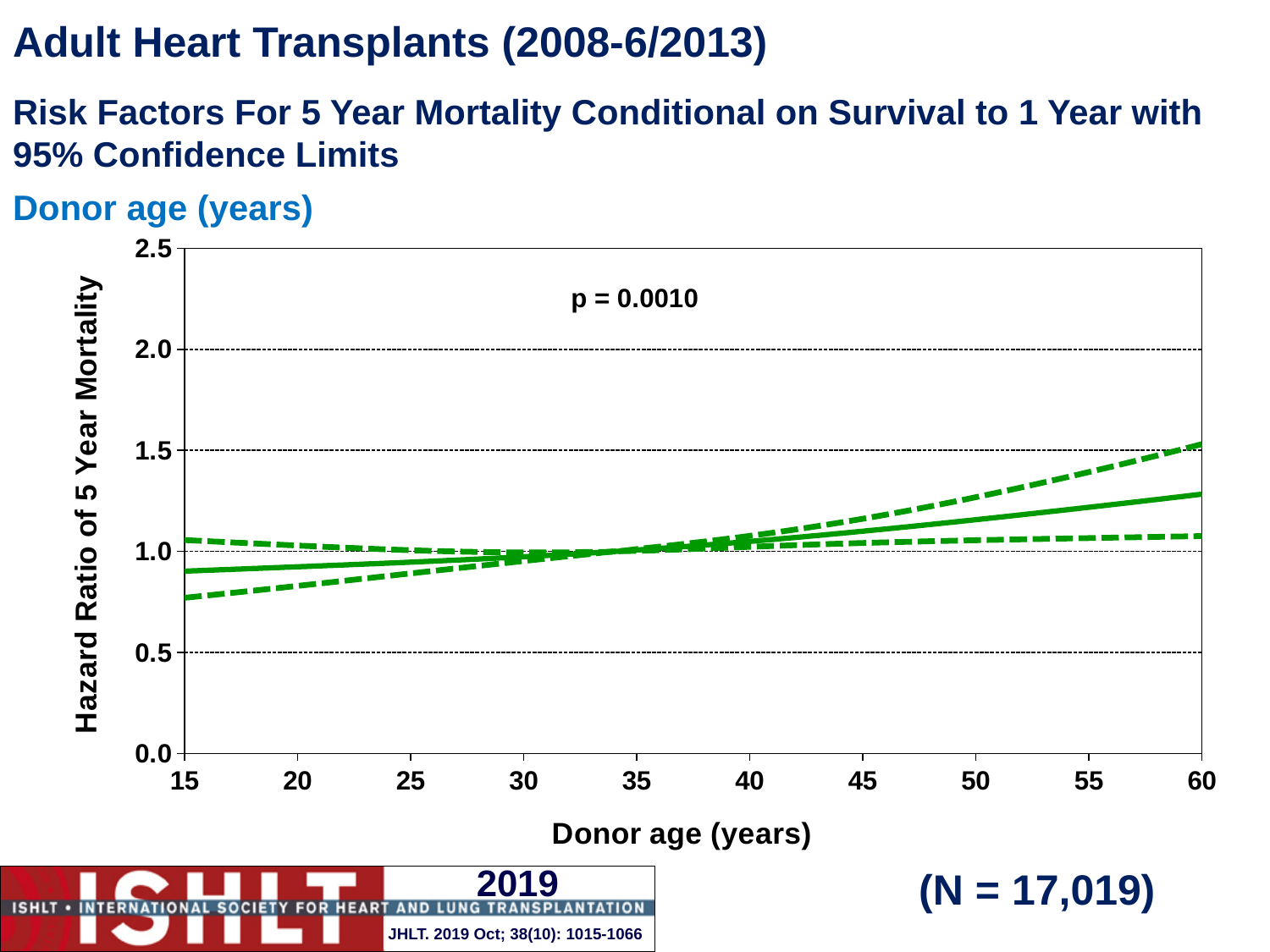
What sample size (N) is shown on the slide? N = 17,019 Is the hazard ratio (solid line) at donor age 60 greater or less than 1.0? greater What p-value is printed on the chart? p = 0.0010 Does the solid hazard ratio line rise or fall as donor age increases from 15 to 60 years? rises Is the lower confidence limit (lower dashed line) at donor age 15 greater or less than 1.0? less Is the hazard ratio (solid line) at donor age 60 greater or less than 1.5? less How many lines are plotted on the chart? 3 What kind of chart is shown on the slide? line chart Is the hazard ratio (solid line) larger at donor age 60 or at donor age 15? 60